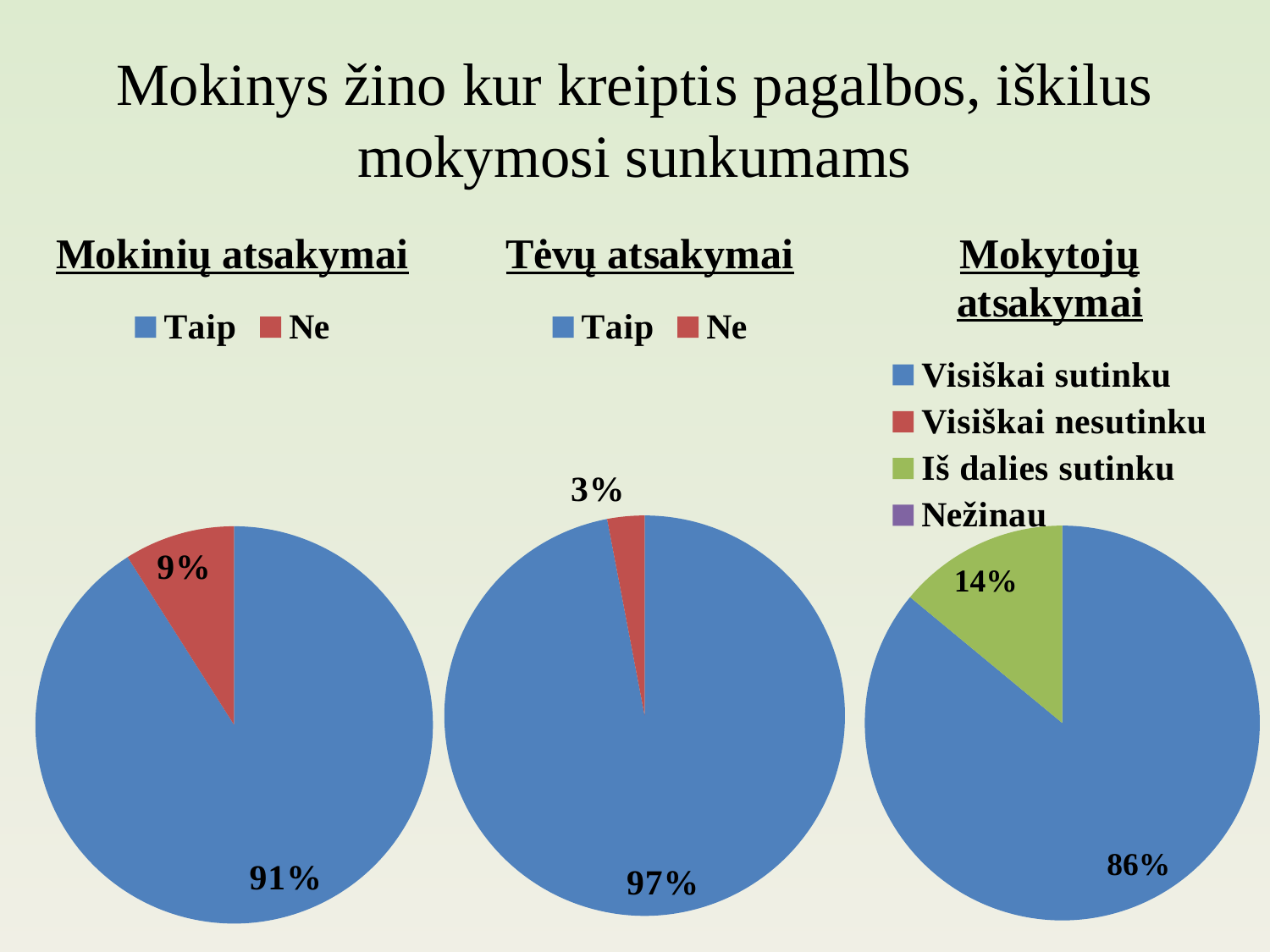
In the 'Mokytojų atsakymai' chart, what percentage is shown for 'Iš dalies sutinku'? 14% How many pie charts are shown on the slide? 3 In the 'Mokytojų atsakymai' chart, what percentage is shown for 'Visiškai sutinku'? 86% How many entries does the legend of the 'Mokytojų atsakymai' chart list? 4 What type of chart is the 'Tėvų atsakymai' chart? Pie chart In the 'Mokytojų atsakymai' chart, which category has the largest slice? Visiškai sutinku Which is larger: the 'Ne' share in the 'Mokinių atsakymai' chart or the 'Ne' share in the 'Tėvų atsakymai' chart? Mokinių atsakymai In the 'Mokinių atsakymai' chart, what percentage is shown for 'Ne'? 9% In the 'Mokinių atsakymai' chart, what percentage is shown for 'Taip'? 91% In the 'Tėvų atsakymai' chart, what percentage is shown for 'Ne'? 3% In the 'Mokinių atsakymai' chart, what is the difference between the 'Taip' and 'Ne' percentages? 82% In the 'Tėvų atsakymai' chart, what percentage is shown for 'Taip'? 97%